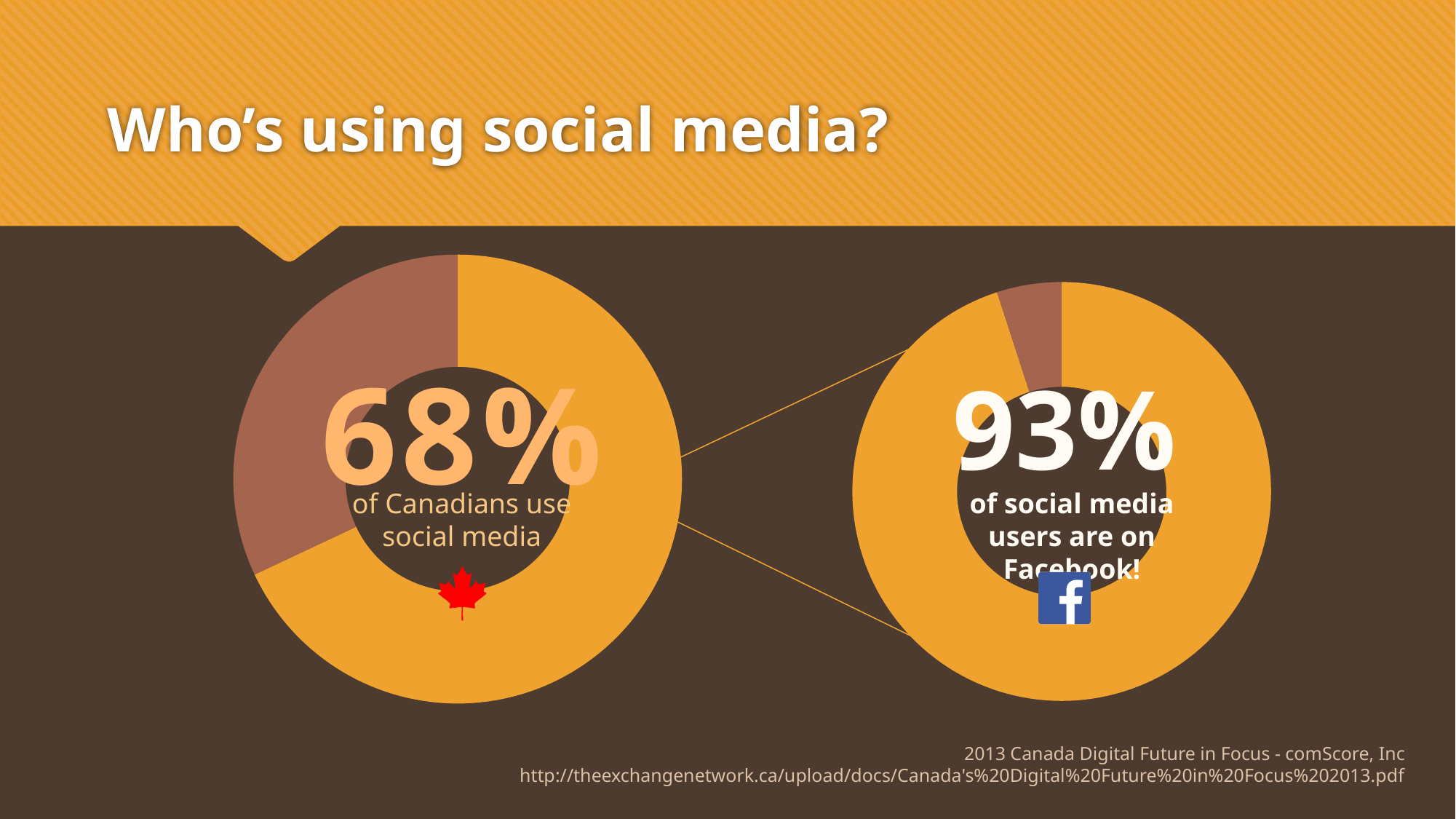
On the left chart, what percentage of Canadians use social media? 68% On the right chart, what percentage of social media users are on Facebook? 93% What is the title of the slide? Who's using social media? Which chart shows the larger highlighted share, the left chart or the right chart? The right chart What kind of chart is used on the left side of the slide? Donut (pie) chart What is the difference between the percentage on the right chart and the percentage on the left chart? 25% How many charts are shown on the slide? 2 On the left chart, what share of the donut does the orange segment represent? 68% On the right chart, what share of the donut does the orange segment represent? 93% Is the highlighted share on the left chart greater or less than 50%? greater What kind of chart is used on the right side of the slide? Donut (pie) chart What colour is the highlighted segment in both donut charts? Orange